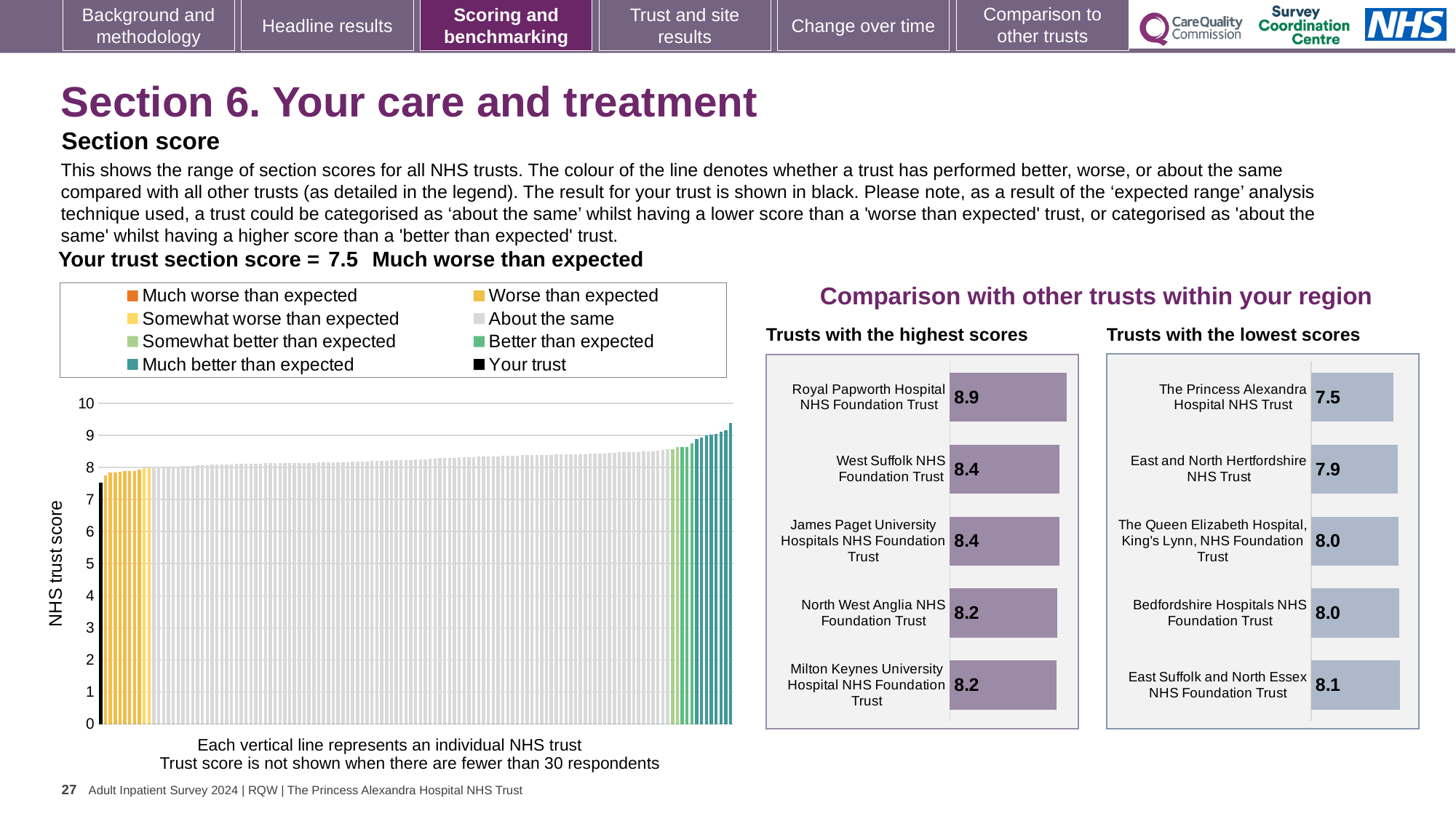
In the 'Trusts with the lowest scores' chart, what is the score for Bedfordshire Hospitals NHS Foundation Trust? 8.0 In the 'Trusts with the lowest scores' chart, how much higher is East Suffolk and North Essex NHS Foundation Trust's score than The Princess Alexandra Hospital NHS Trust's score? 0.6 In the 'Trusts with the highest scores' chart, what is the score for Royal Papworth Hospital NHS Foundation Trust? 8.9 In the large NHS trust score chart on the left, do the values rise or fall from left to right? Rise How many trusts are shown in the 'Trusts with the highest scores' chart? 5 In the 'Trusts with the highest scores' chart, what is the difference between the scores of Royal Papworth Hospital NHS Foundation Trust and Milton Keynes University Hospital NHS Foundation Trust? 0.7 In the 'Trusts with the highest scores' chart, which trust has the highest score? Royal Papworth Hospital NHS Foundation Trust In the 'Trusts with the lowest scores' chart, what is the score for The Princess Alexandra Hospital NHS Trust? 7.5 In the 'Trusts with the lowest scores' chart, which trust has the lowest score? The Princess Alexandra Hospital NHS Trust How many entries does the legend of the large NHS trust score chart on the left list? 8 In the 'Trusts with the highest scores' chart, which has the higher score: West Suffolk NHS Foundation Trust or North West Anglia NHS Foundation Trust? West Suffolk NHS Foundation Trust What type of chart is the large chart on the left showing NHS trust scores? Bar chart